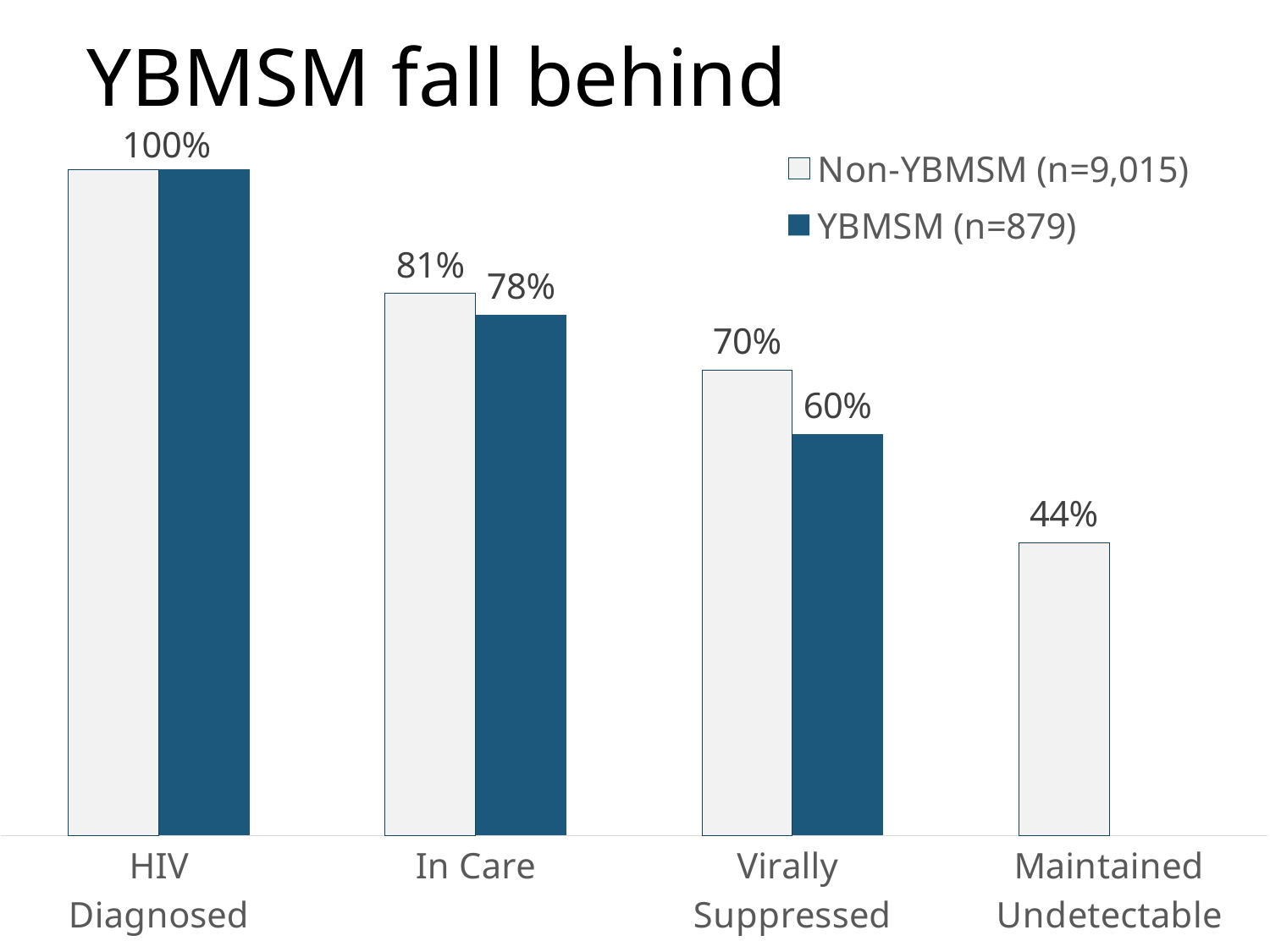
What is the Non-YBMSM value for In Care? 81% What is the YBMSM value for In Care? 78% What is the Non-YBMSM value for Virally Suppressed? 70% Which category has the lowest Non-YBMSM value? Maintained Undetectable How many categories are shown on the x axis? 4 Which is larger for Virally Suppressed, the Non-YBMSM value or the YBMSM value? Non-YBMSM What kind of chart is shown on the slide? Bar chart What is the YBMSM value for Virally Suppressed? 60% What is the difference between the Non-YBMSM and YBMSM values for Virally Suppressed? 10% What is the difference between the Non-YBMSM and YBMSM values for In Care? 3% What is the Non-YBMSM value for Maintained Undetectable? 44% How many series does the legend list? 2